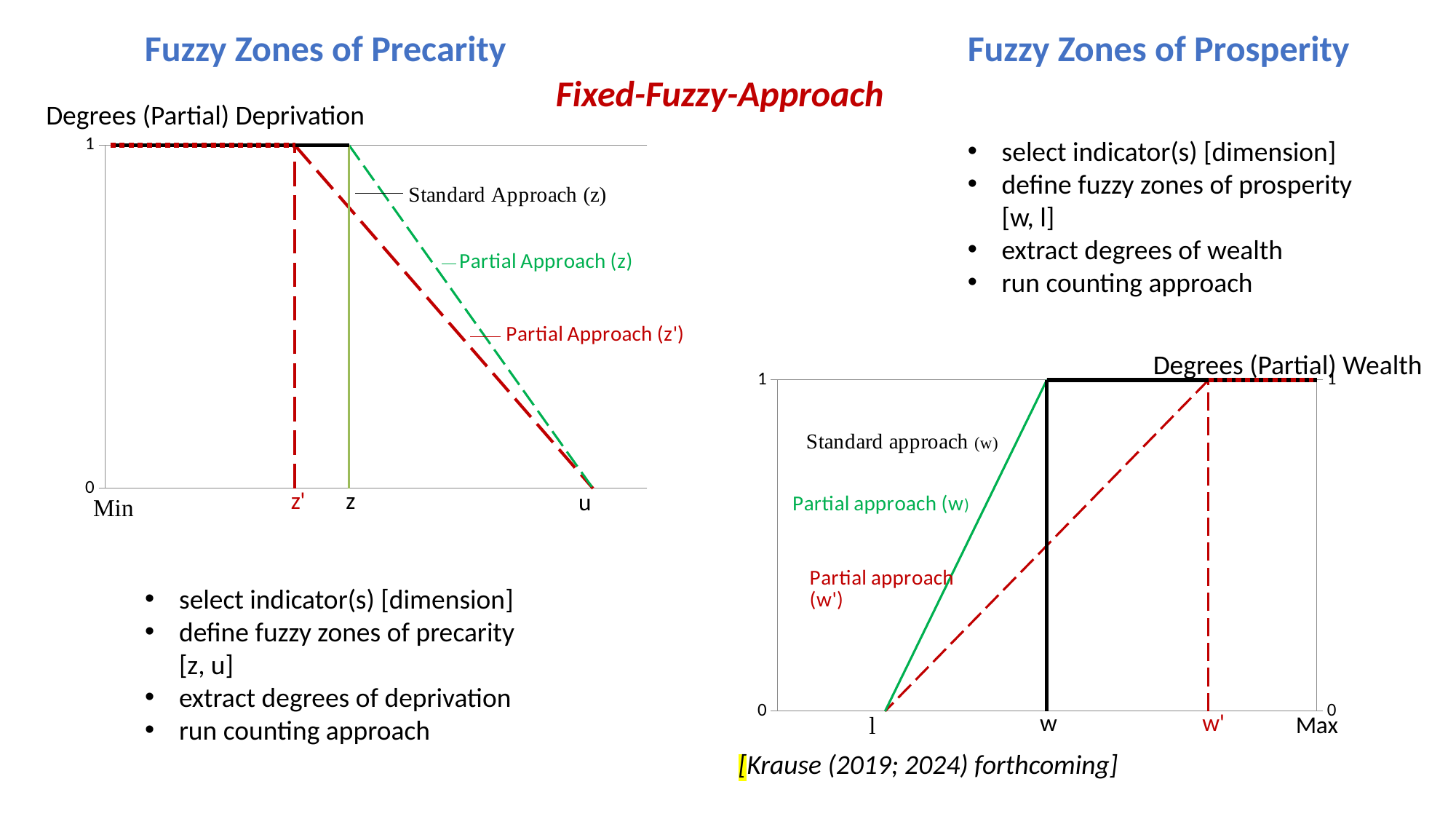
In the left chart 'Degrees (Partial) Deprivation', what is the value of the Partial Approach (z') line at z'? 1 In the right chart 'Degrees (Partial) Wealth', how many approaches (lines) are labelled? 3 In the left chart 'Degrees (Partial) Deprivation', how many approaches (lines) are labelled? 3 In the right chart 'Degrees (Partial) Wealth', do the Partial approach lines rise or fall as the x axis moves from l toward w'? rise In the left chart 'Degrees (Partial) Deprivation', what are the labels shown on the x axis? Min, z', z, u In the right chart 'Degrees (Partial) Wealth', what is the value of the Partial approach (w) line at l? 0 What kind of chart is the right chart, titled 'Degrees (Partial) Wealth'? line chart In the right chart 'Degrees (Partial) Wealth', what value does the Partial approach (w') line reach at w'? 1 In the right chart 'Degrees (Partial) Wealth', what colour is the Partial approach (w') line? red What kind of chart is the left chart, titled 'Degrees (Partial) Deprivation'? line chart In the left chart 'Degrees (Partial) Deprivation', what value does the Partial Approach (z) line reach at u? 0 In the left chart 'Degrees (Partial) Deprivation', do the Partial Approach lines rise or fall as the x axis moves from z toward u? fall